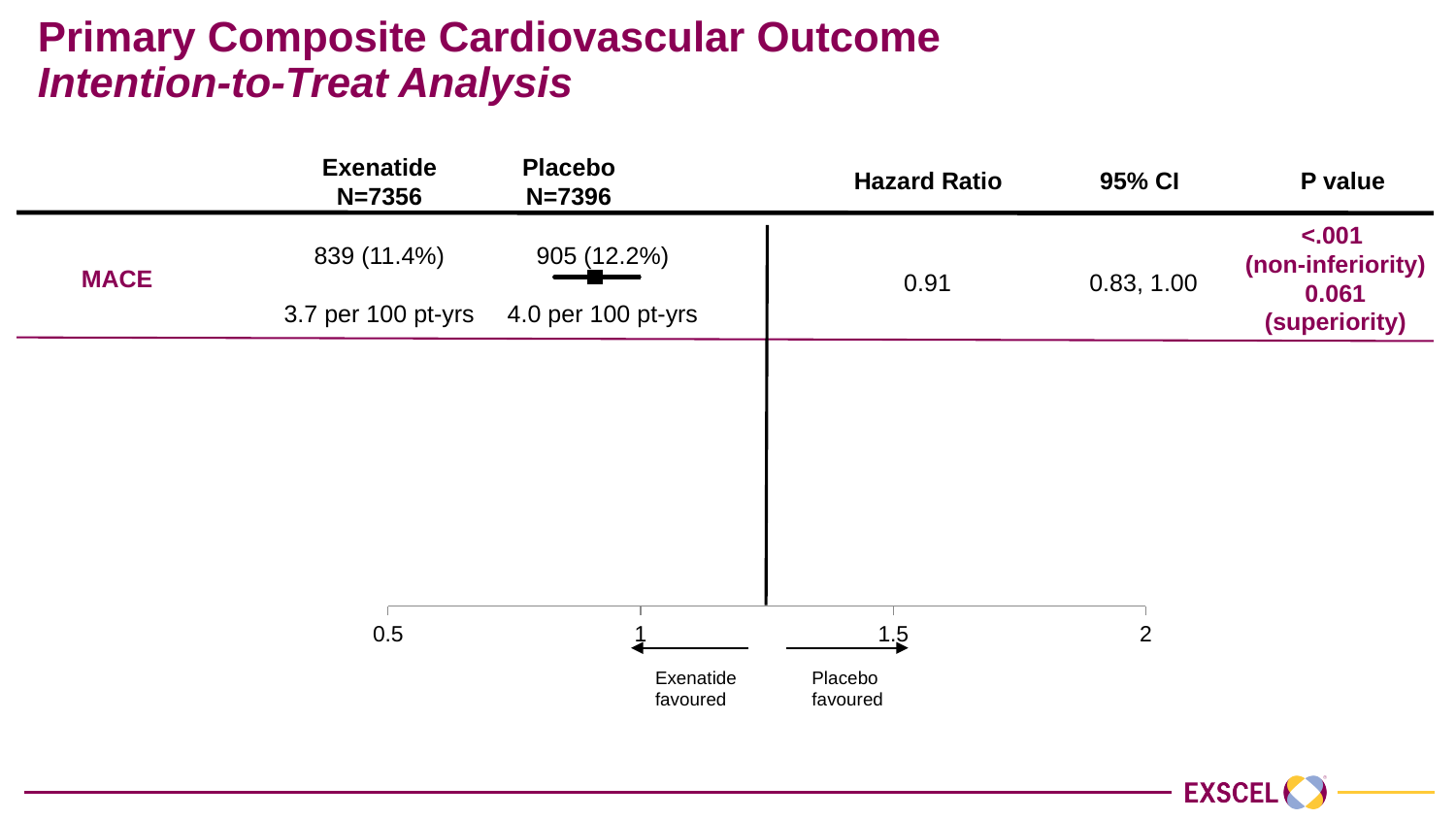
Which side of the plot is labelled 'Exenatide favoured', the left or the right? left How many outcomes are plotted on the forest plot? 1 Which group has the higher number of MACE events, Exenatide or Placebo? Placebo What is the 95% confidence interval shown for the MACE hazard ratio? 0.83, 1.00 Is the plotted hazard ratio for MACE greater or less than 1? less What is the hazard ratio shown for MACE? 0.91 How many MACE events are reported in the Exenatide group? 839 (11.4%) What is the P value for non-inferiority shown on the slide? <.001 What is the P value for superiority shown on the slide? 0.061 What is the MACE event rate per 100 patient-years in the Placebo group? 4.0 per 100 pt-yrs How many MACE events are reported in the Placebo group? 905 (12.2%) What is the difference in the number of MACE events between the Placebo and Exenatide groups? 66